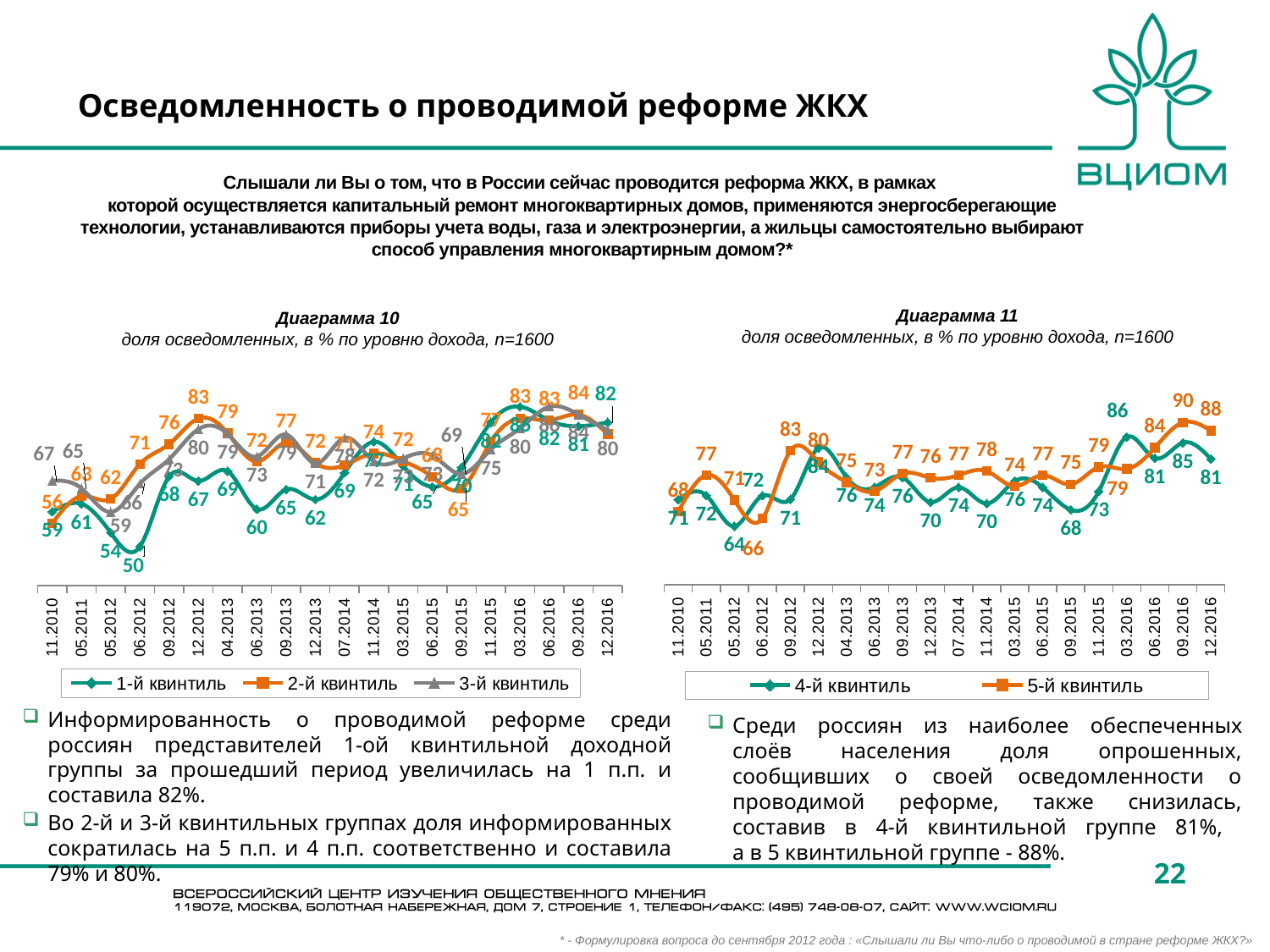
How many time points are shown on the x axis of Диаграмма 11? 20 In Диаграмма 11, at which date does 5-й квинтиль reach its highest value? 09.2016 In Диаграмма 10, at which date does 1-й квинтиль reach its lowest value? 06.2012 How many series does the legend of Диаграмма 10 list? 3 In Диаграмма 10, what is the value for 1-й квинтиль at 06.2012? 50 How many series does the legend of Диаграмма 11 list? 2 In Диаграмма 11, what is the value for 4-й квинтиль at 03.2016? 86 In Диаграмма 11, which series has the larger value at 09.2016, 4-й квинтиль or 5-й квинтиль? 5-й квинтиль In Диаграмма 11, what is the difference between 5-й квинтиль and 4-й квинтиль at 12.2016? 7 What type of chart is Диаграмма 10? Line chart In Диаграмма 11, what is the value for 5-й квинтиль at 09.2016? 90 In Диаграмма 11, what is the value for 4-й квинтиль at 12.2016? 81